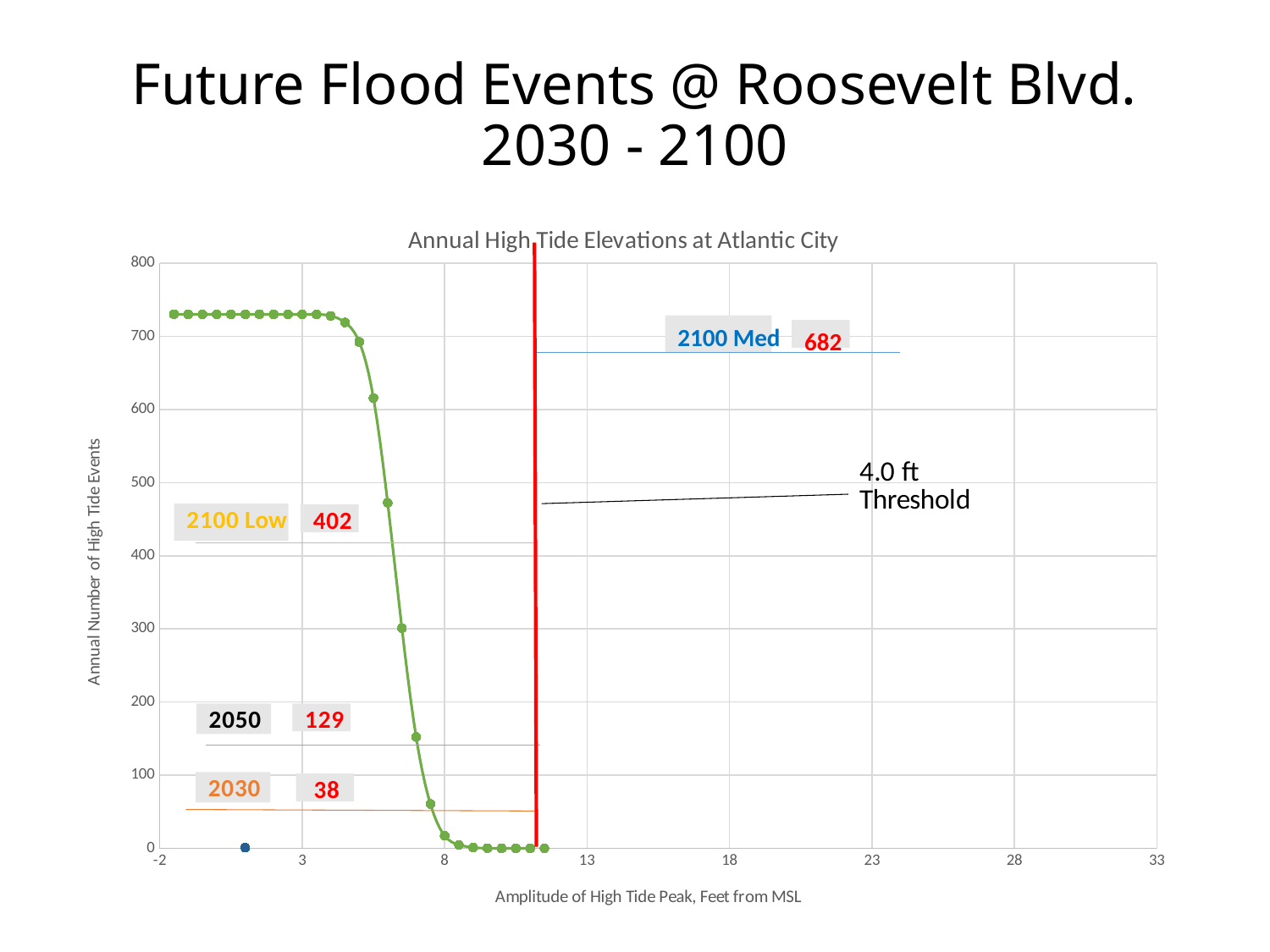
Which labelled scenario has the lowest number of high tide events? 2030 Which is larger, the 2050 value or the 2100 Low value? 2100 Low Which labelled scenario has the highest number of high tide events? 2100 Med What is the difference between the 2050 value and the 2030 value? 91 Does the green curve rise or fall as the amplitude of high tide peak increases? fall What value is labelled for the 2050 scenario? 129 What is the difference between the 2100 Med value and the 2100 Low value? 280 What value is labelled for the 2100 Med scenario? 682 Is the value of the green curve at an amplitude of 3 feet greater or less than 700? greater What is the title of the chart? Annual High Tide Elevations at Atlantic City What value is labelled for the 2100 Low scenario? 402 What is the annual number of high tide events shown for the 2030 scenario? 38